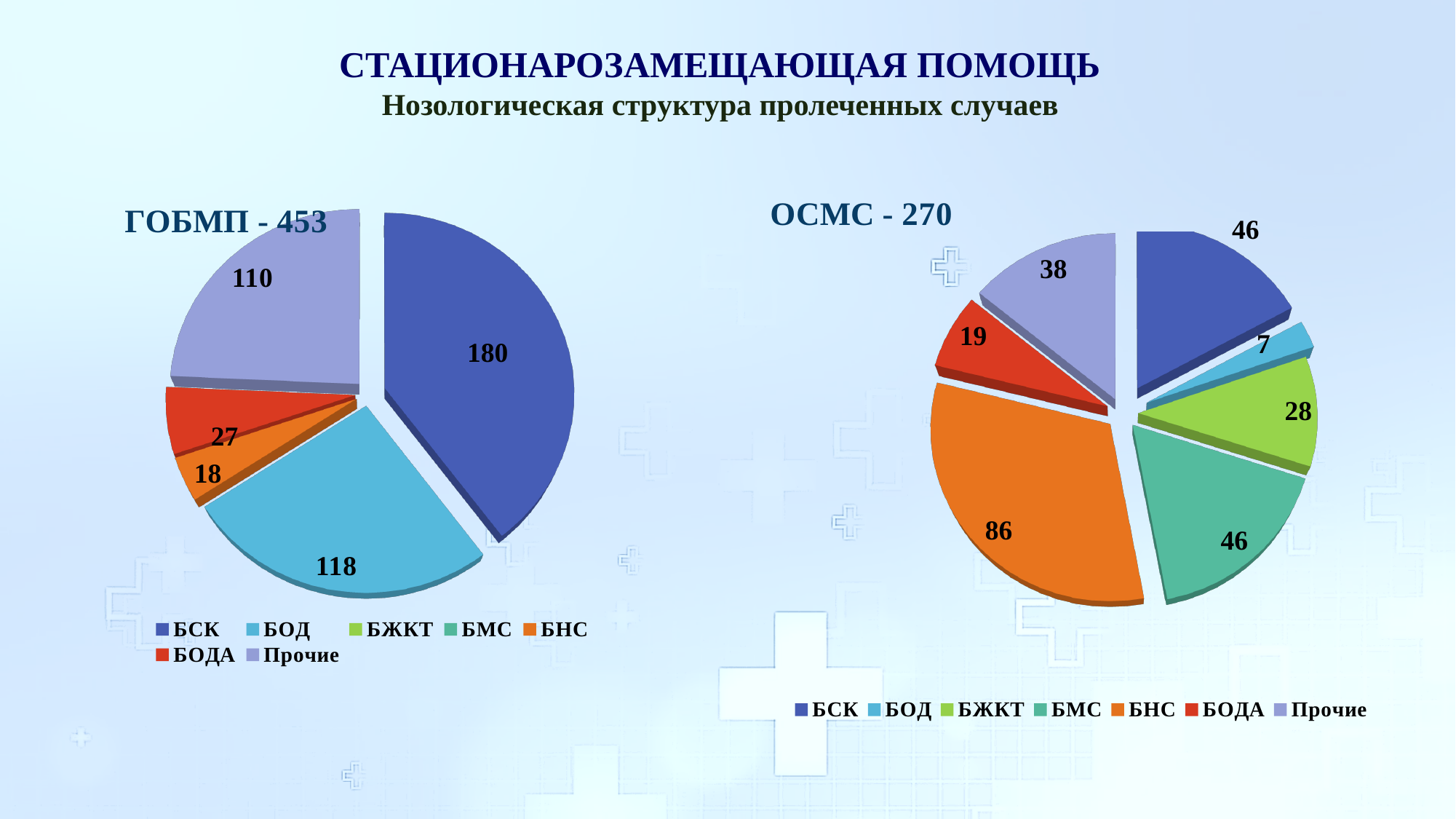
In the ГОБМП - 453 chart, which category has the smallest slice? БНС In the ГОБМП - 453 chart, what is the difference between БСК and БОД? 62 In the ОСМС - 270 chart, how many slices does the pie have? 7 What type of charts are shown on the slide? Pie charts In the ОСМС - 270 chart, which is larger, БОДА or Прочие? Прочие In the ОСМС - 270 chart, what is the value for БНС? 86 In the ГОБМП - 453 chart, what is the value for БСК? 180 How many categories does the legend of the ОСМС - 270 chart list? 7 In the ОСМС - 270 chart, which category has the smallest slice? БОД In the ОСМС - 270 chart, what is the value for БЖКТ? 28 In the ОСМС - 270 chart, which category has the largest slice? БНС In the ГОБМП - 453 chart, what is the value for Прочие? 110